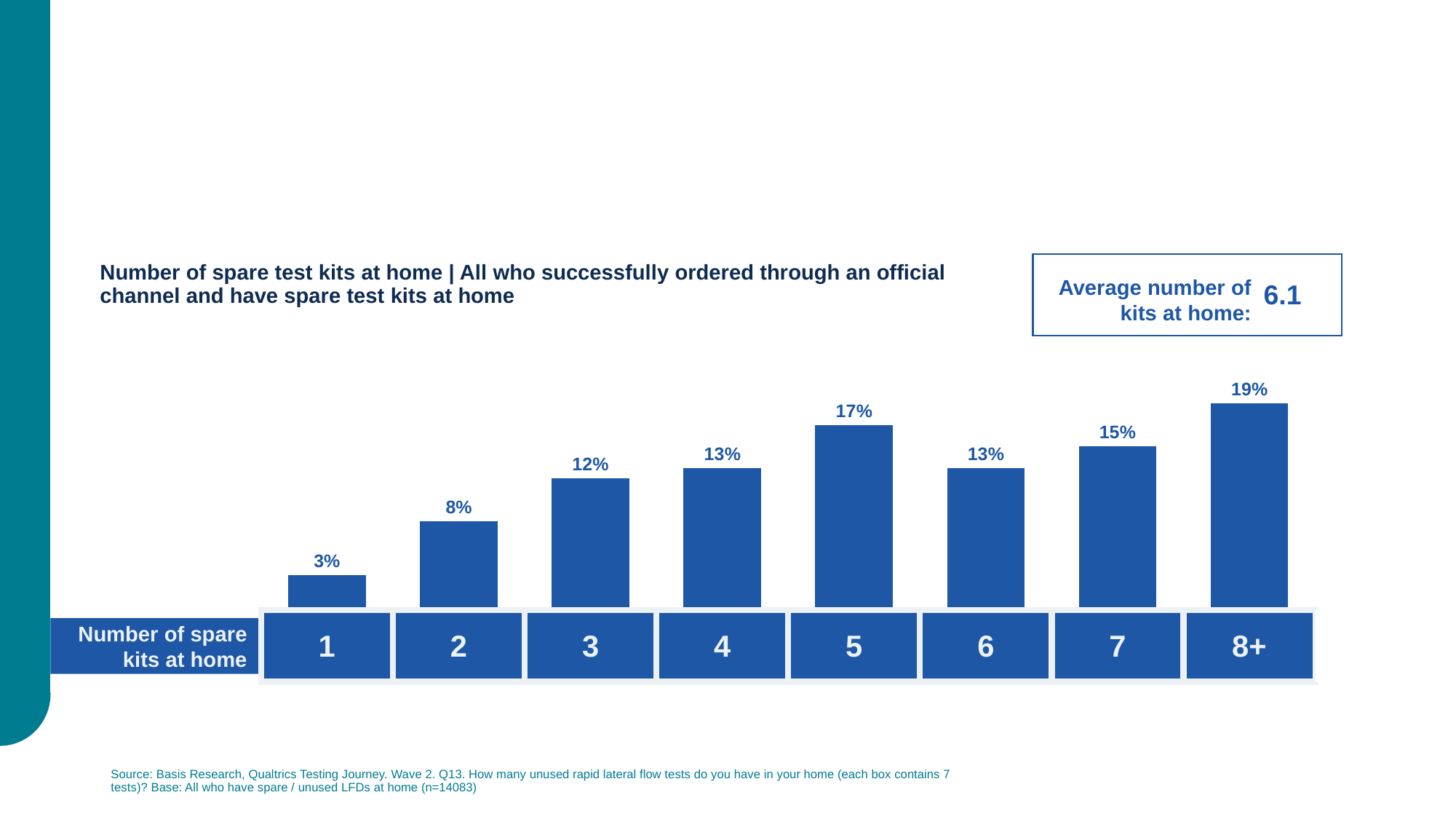
What is the difference in percentage points between 8+ spare kits and 1 spare kit? 16 What percentage of respondents have 5 spare test kits at home? 17% What is the difference in percentage points between 5 spare kits and 6 spare kits? 4 What percentage of respondents have 1 spare test kit at home? 3% What percentage of respondents have 8+ spare test kits at home? 19% How many categories of spare kits at home are shown on the chart? 8 Which two categories both have a value of 13%? 4 and 6 Which has a higher percentage: 2 spare kits or 7 spare kits? 7 Which number of spare kits at home has the lowest percentage? 1 Which number of spare kits at home has the highest percentage? 8+ What kind of chart is shown on the slide? Bar chart What is the average number of kits at home shown in the box on the slide? 6.1